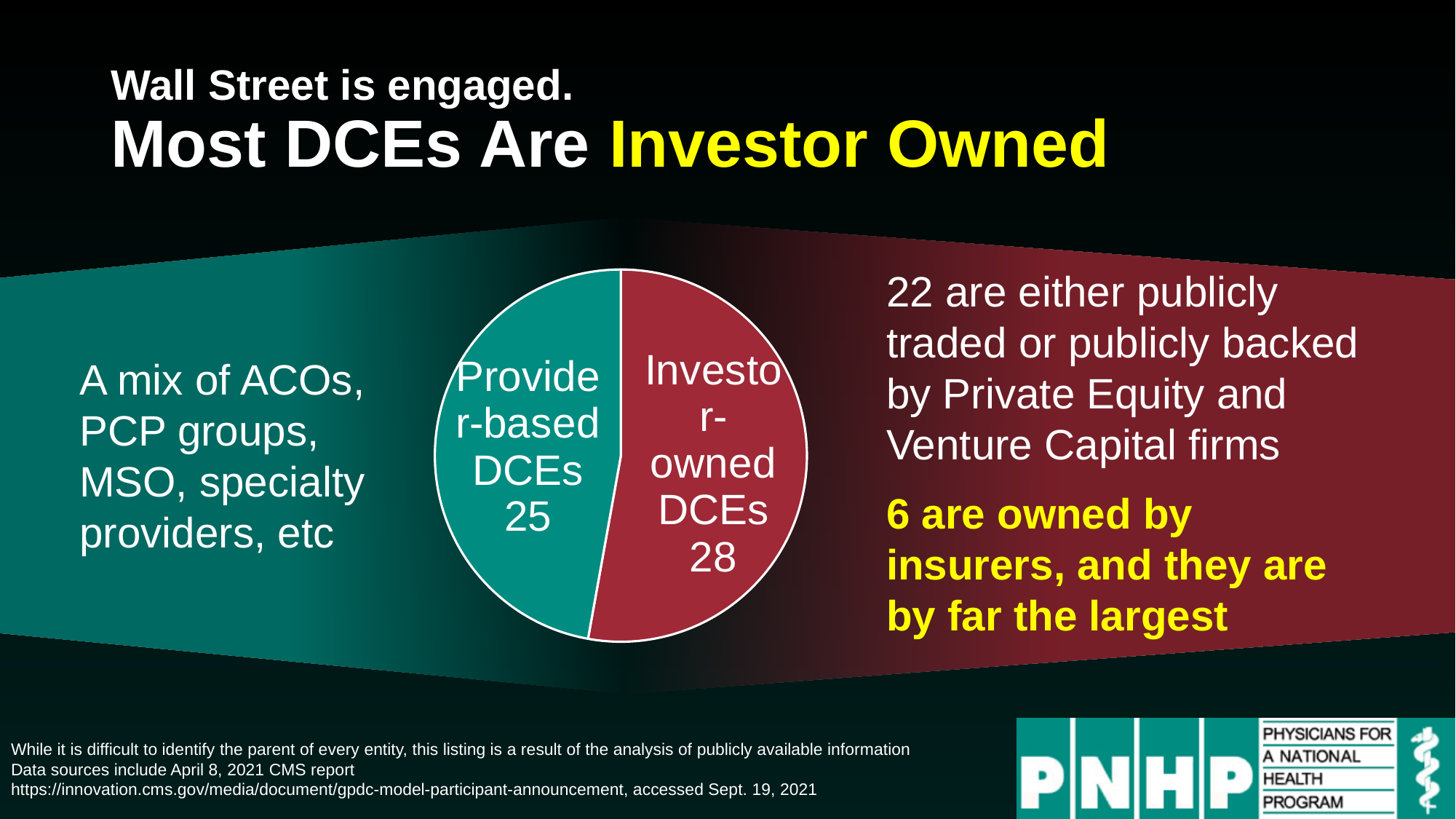
What is the difference between the number of Investor-owned DCEs and Provider-based DCEs? 3 What is the value for Investor-owned DCEs in the pie chart? 28 What colour is the Investor-owned DCEs slice of the pie chart? red Which slice of the pie chart is the smallest? Provider-based DCEs What kind of chart is shown on the slide? pie chart Which slice of the pie chart is the largest? Investor-owned DCEs What is the value for Provider-based DCEs in the pie chart? 25 What colour is the Provider-based DCEs slice of the pie chart? teal Which is larger in the pie chart, Provider-based DCEs or Investor-owned DCEs? Investor-owned DCEs What is the total number of DCEs represented in the pie chart? 53 How many slices does the pie chart have? 2